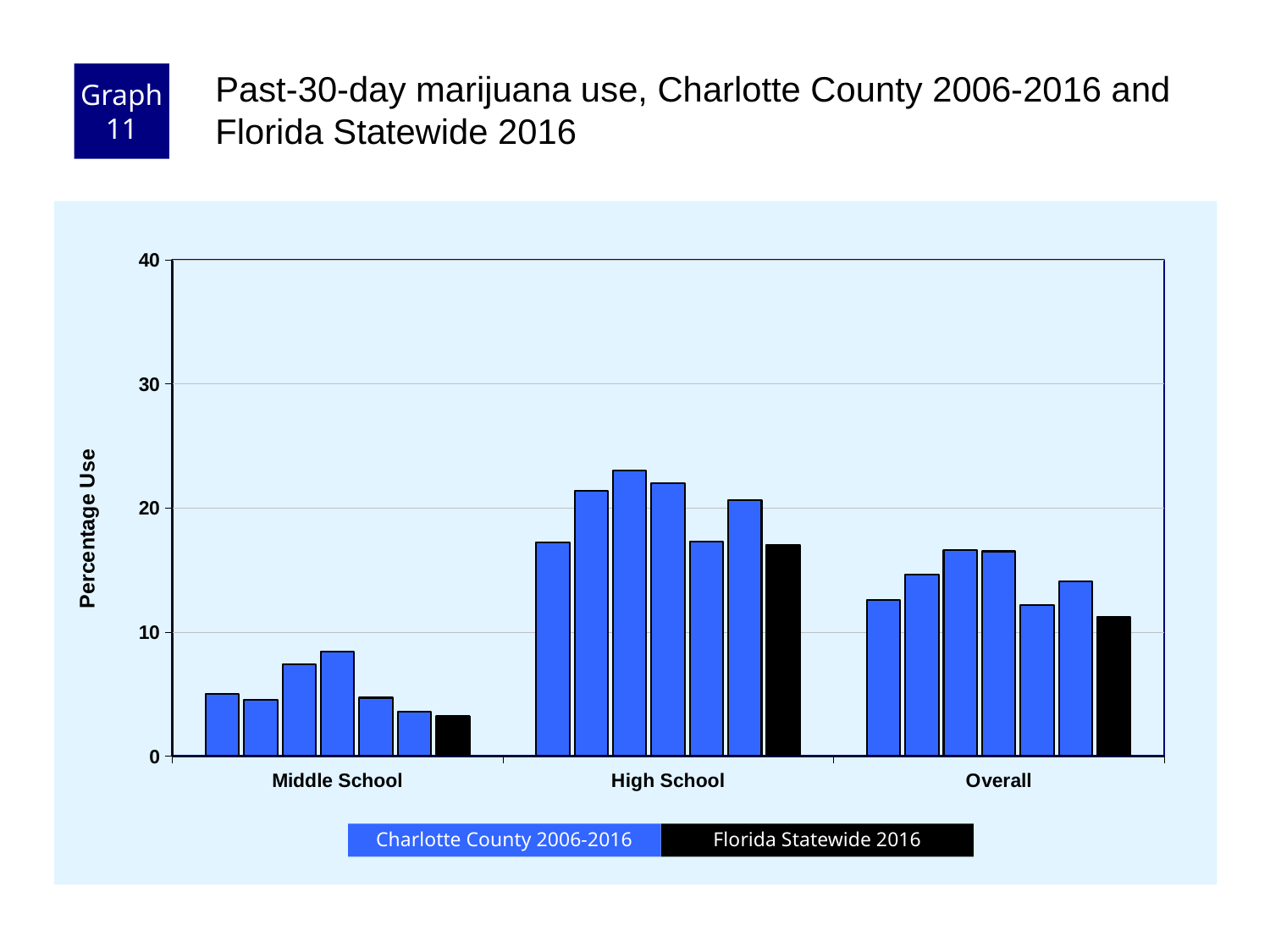
What is the label on the y axis? Percentage Use Which category has the shortest bars overall? Middle School How many categories are shown along the x axis? 3 Is the highest Charlotte County bar for High School greater or less than 20? greater Is the Florida Statewide 2016 value for Middle School greater or less than 10? less Is the Florida Statewide 2016 value for High School greater or less than 10? greater How many series does the legend list? 2 Which colour represents Florida Statewide 2016 in the legend? black What kind of chart is shown on the slide? bar chart Which category has the tallest bars overall? High School Which is larger: the Florida Statewide 2016 bar for High School or the Florida Statewide 2016 bar for Overall? High School